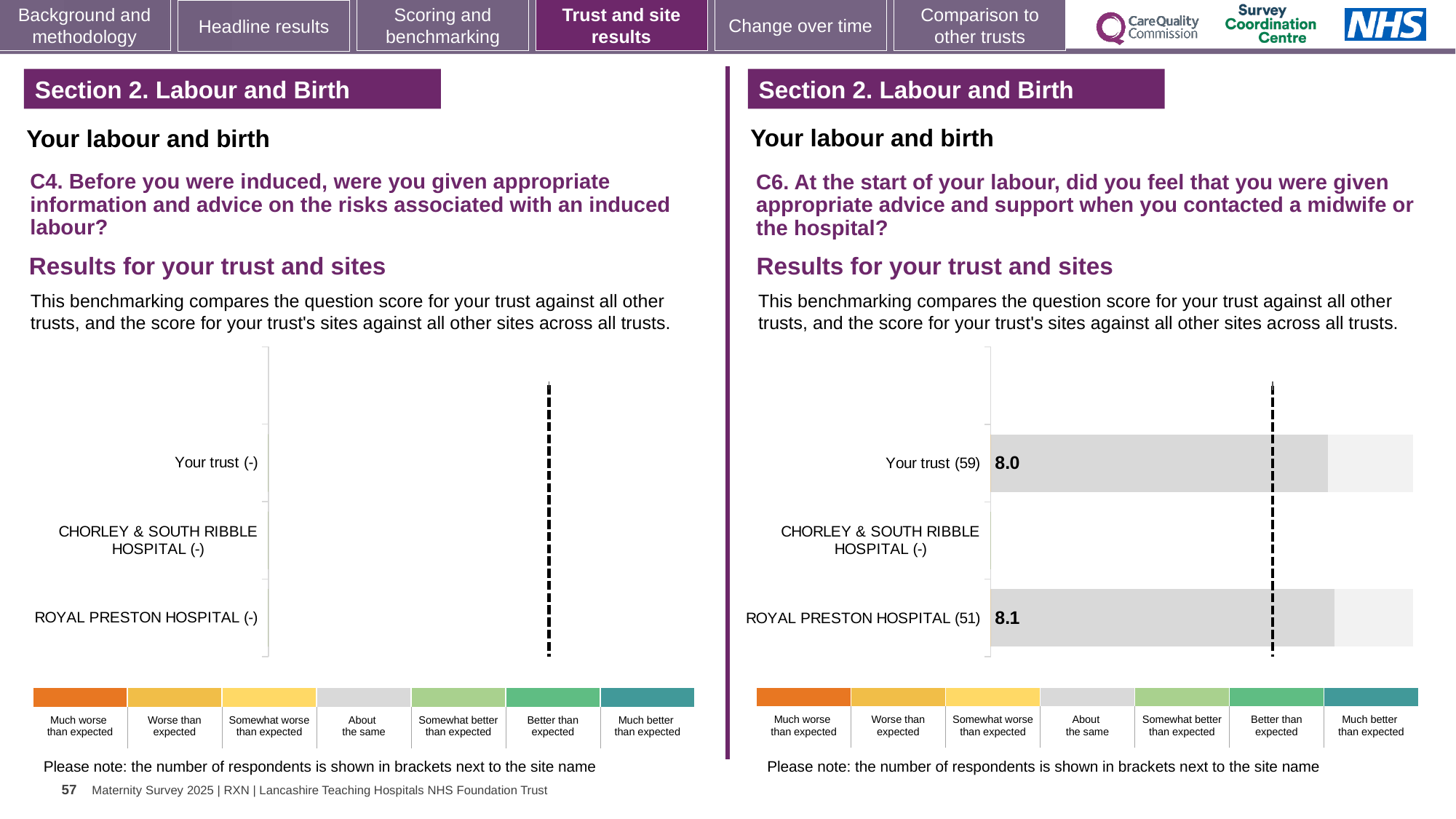
How many rating categories does the colour legend below the C6 chart on the right list? 7 In the C4 chart on the left, how many scores are plotted? 0 In the C6 chart on the right, how many respondents are shown in brackets for Your trust? 59 In the C6 chart on the right, how many respondents are shown in brackets for ROYAL PRESTON HOSPITAL? 51 In the C6 chart on the right, what is the score for Your trust? 8.0 What kind of chart is the C6 chart on the right? Bar chart In the C6 chart on the right, which is higher: the score for Your trust or the score for ROYAL PRESTON HOSPITAL? ROYAL PRESTON HOSPITAL How many rows (categories) are listed in the C6 chart on the right? 3 In the C6 chart on the right, which row has no score shown? CHORLEY & SOUTH RIBBLE HOSPITAL In the C6 chart on the right, what is the score for ROYAL PRESTON HOSPITAL? 8.1 In the C6 chart on the right, what is the difference between the ROYAL PRESTON HOSPITAL score and the Your trust score? 0.1 How many rows (categories) are listed in the C4 chart on the left? 3